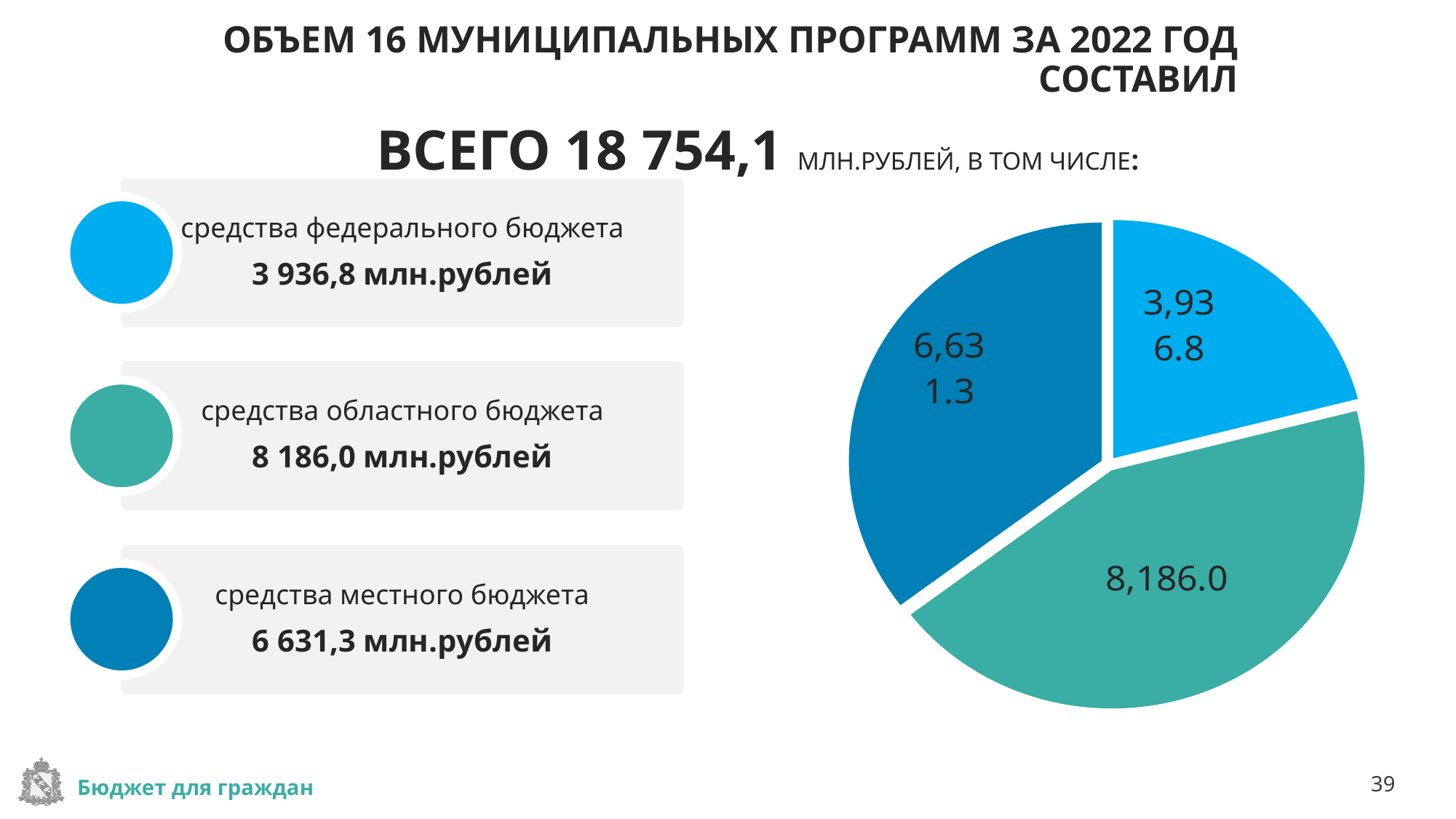
How many slices does the pie chart have? 3 What is the difference between the regional budget value and the local budget value? 1,554.7 What kind of chart is shown on the slide? pie chart What value is shown for the federal budget funds (средства федерального бюджета) slice? 3,936.8 What is the total of all three slices in the pie chart, in million rubles? 18 754,1 Which funding source has the smallest slice of the pie? средства федерального бюджета Which is larger: the local budget slice or the federal budget slice? local budget (средства местного бюджета) What share of the total does the regional budget slice represent? 43.6% Which funding source has the largest slice of the pie? средства областного бюджета What value is shown for the local budget funds (средства местного бюджета) slice? 6,631.3 What value is shown for the regional budget funds (средства областного бюджета) slice? 8,186.0 What colour is the slice for the local budget funds? dark blue